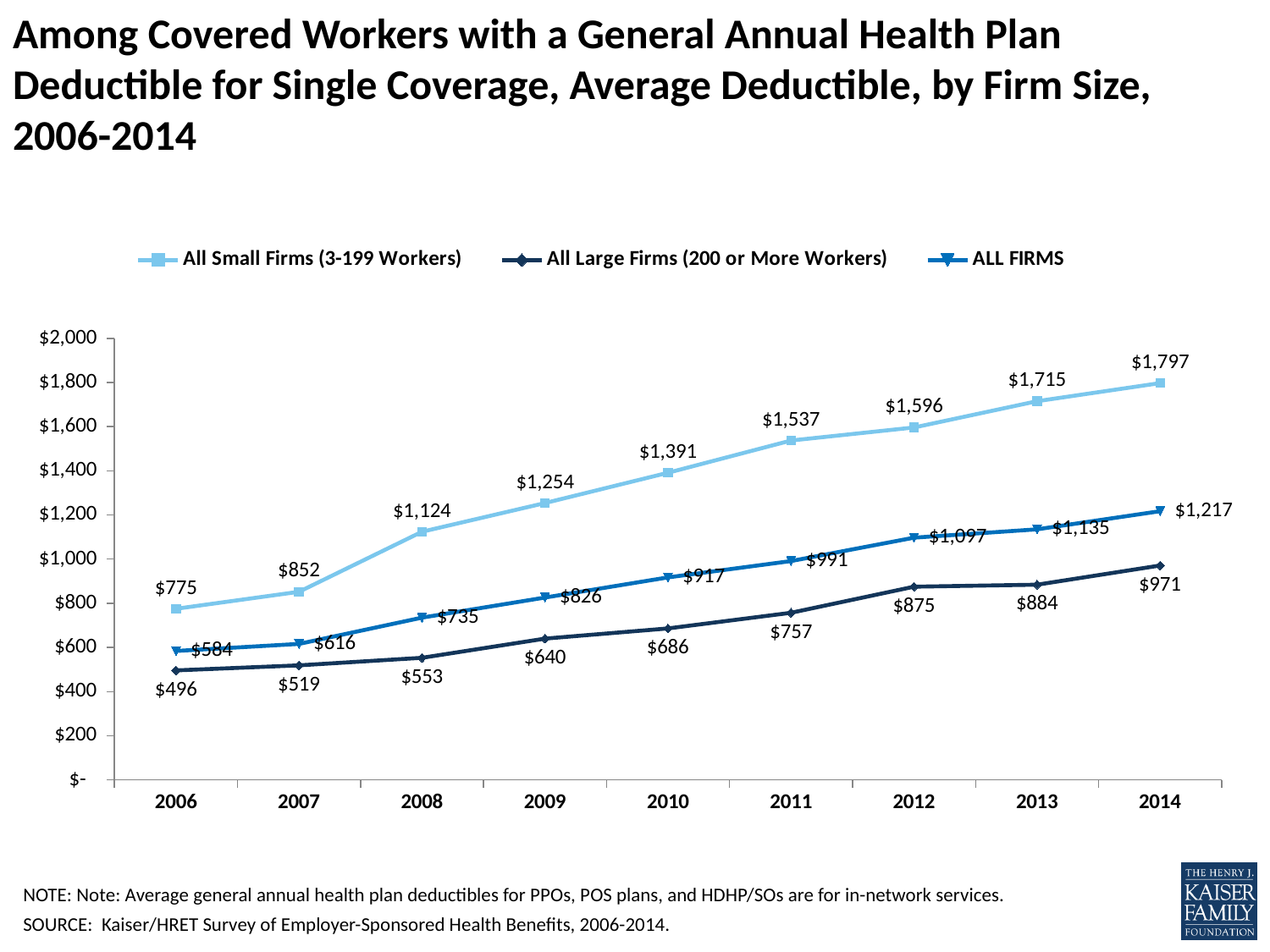
In which year was the average deductible for All Small Firms (3-199 Workers) highest? 2014 How many years are shown on the x axis? 9 What was the average deductible for ALL FIRMS in 2010? $917 What was the average deductible for All Large Firms (200 or More Workers) in 2006? $496 What was the average deductible for All Small Firms (3-199 Workers) in 2014? $1,797 What kind of chart is shown on the slide? Line chart In which year was the average deductible for ALL FIRMS lowest? 2006 Which series had the higher average deductible in 2012: All Large Firms (200 or More Workers) or ALL FIRMS? ALL FIRMS How many series does the legend list? 3 What is the difference between the 2014 and 2006 average deductibles for All Small Firms (3-199 Workers)? $1,022 Does the average deductible for All Large Firms (200 or More Workers) rise or fall from 2006 to 2014? Rise What is the difference between the All Small Firms and All Large Firms average deductibles in 2011? $780